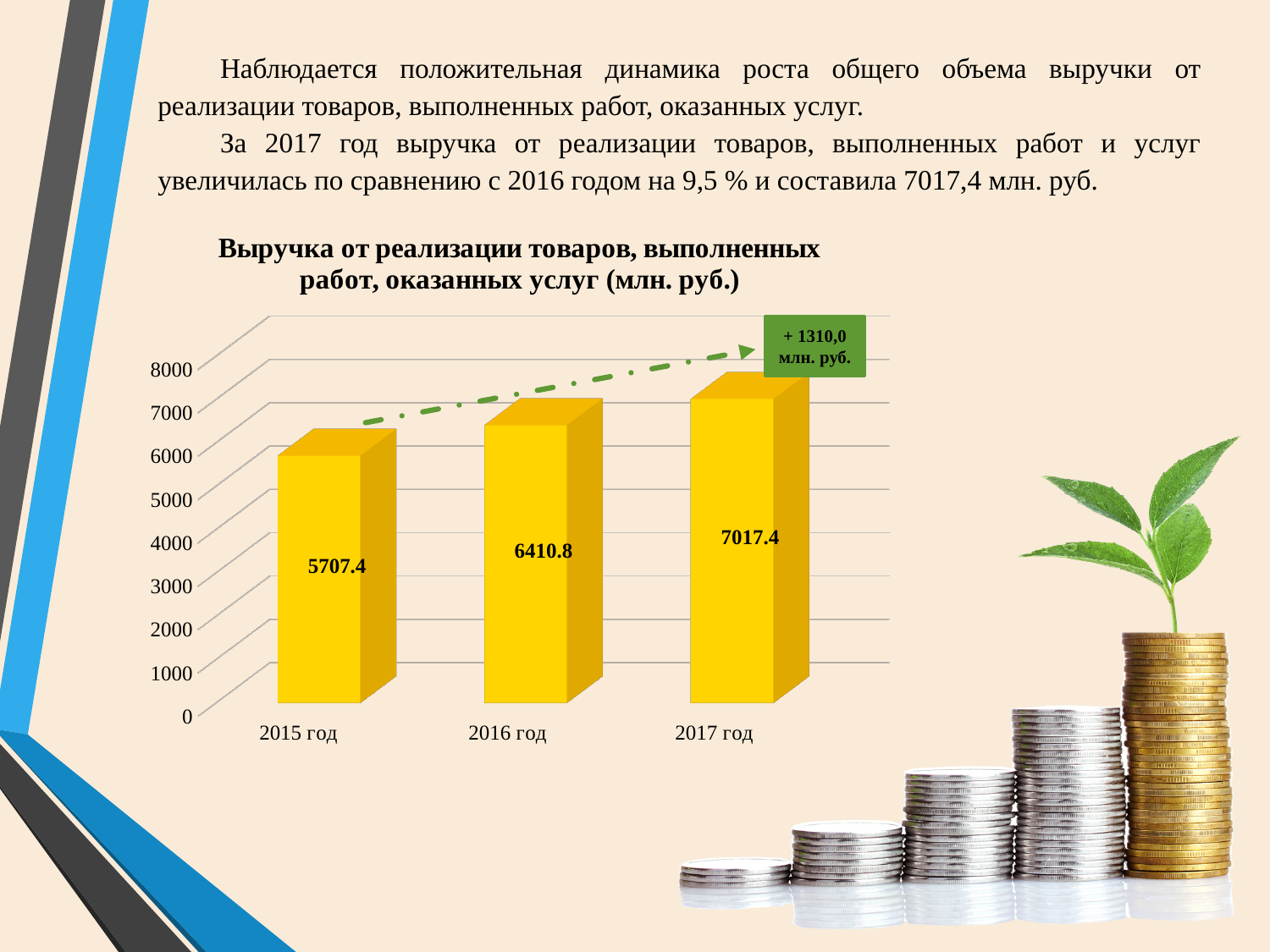
What is the difference between the values for 2017 год and 2015 год? 1310.0 How many years are shown on the chart? 3 Which year has the highest value? 2017 год Which year has the lowest value? 2015 год What is the value for 2017 год? 7017.4 Do the values rise or fall from 2015 год to 2017 год? rise Which is larger, the value for 2016 год or the value for 2017 год? 2017 год What is the value for 2015 год? 5707.4 What is the difference between the values for 2016 год and 2015 год? 703.4 What is the value for 2016 год? 6410.8 Is the value for 2017 год greater or less than 8000? less What kind of chart is shown on the slide? bar chart